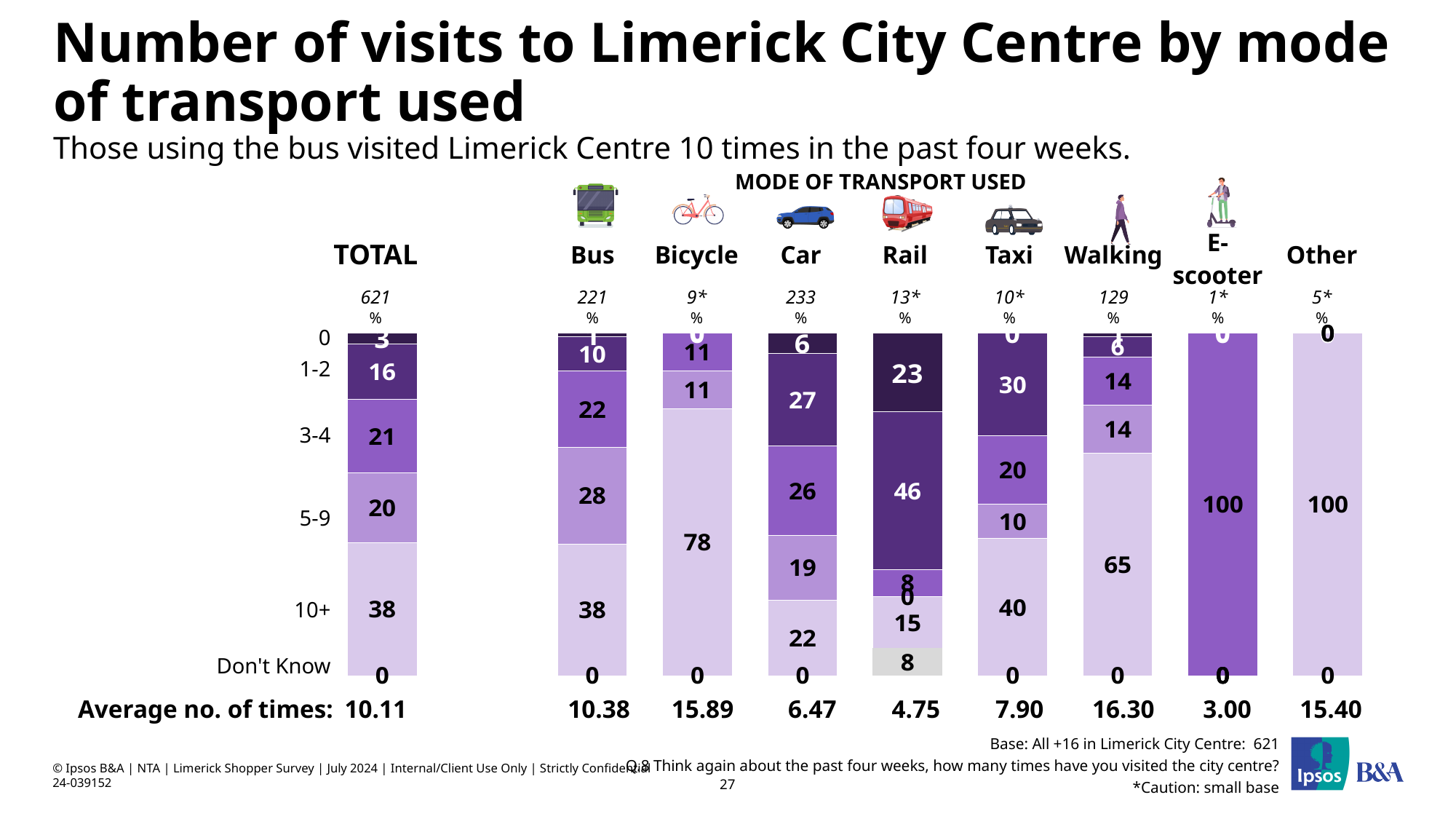
How many modes of transport are shown, excluding the TOTAL column? 8 Which mode of transport has the lowest average number of times? E-scooter What is the base (sample size) shown for Car? 233 What kind of chart is shown on the slide? Stacked bar chart Which has a larger 10+ percentage, Bus or Car? Bus What is the difference between the 10+ percentage for Walking and for Taxi? 25 Which mode of transport has the highest average number of times? Walking What is the average number of times for the TOTAL column? 10.11 What is the average number of times for Walking? 16.30 What is the Don't Know percentage for Rail? 8 What percentage of Rail users visited 1-2 times? 46 What percentage of Bus users visited 10+ times? 38